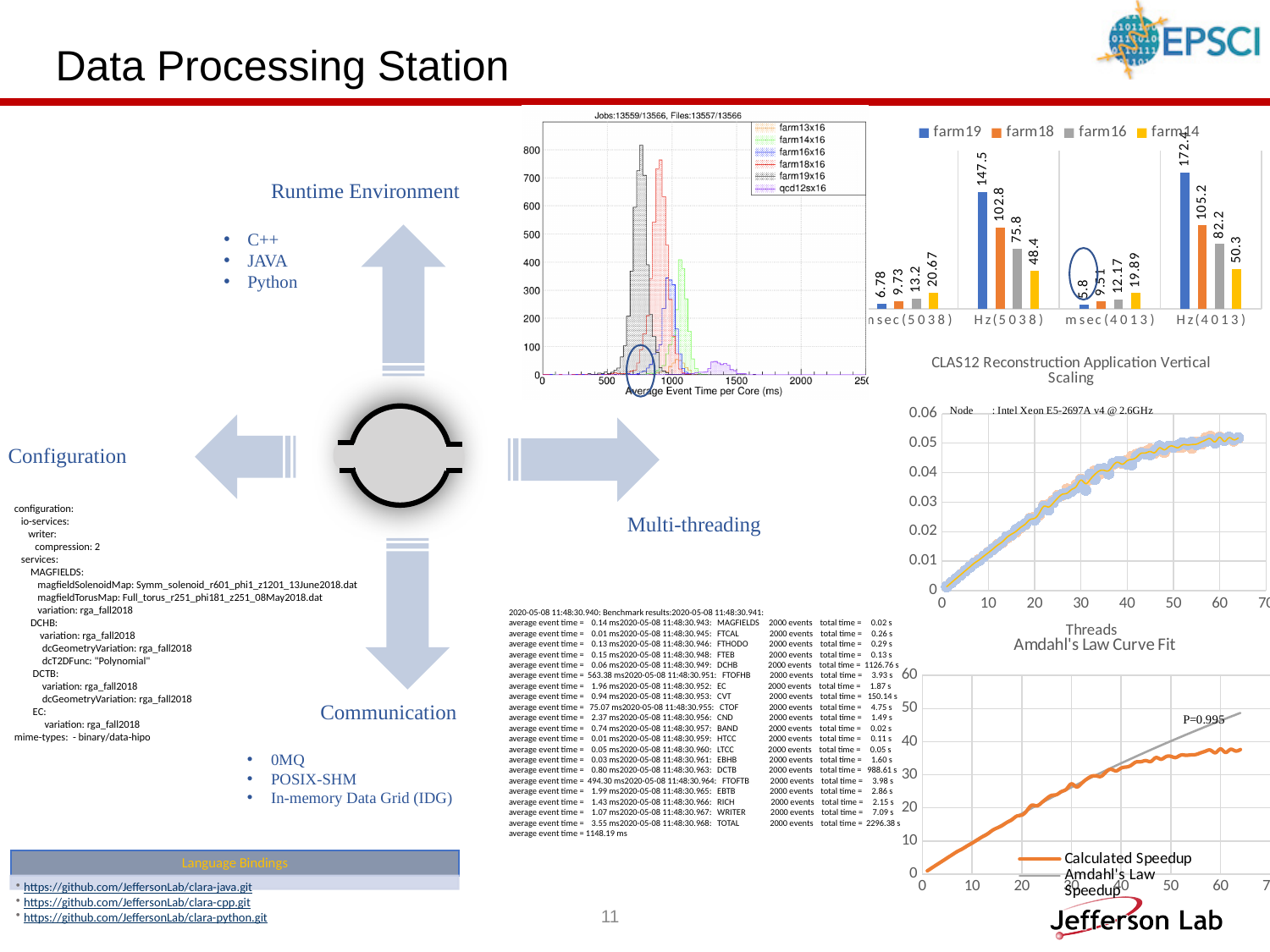
In the Amdahl's Law Curve Fit chart, does the Calculated Speedup rise or fall as the number of threads increases? rise In the Amdahl's Law Curve Fit chart, is the Calculated Speedup at 60 threads greater or less than 40? less How many series does the legend of the histogram titled Jobs:13559/13566, Files:13557/13566 list? 6